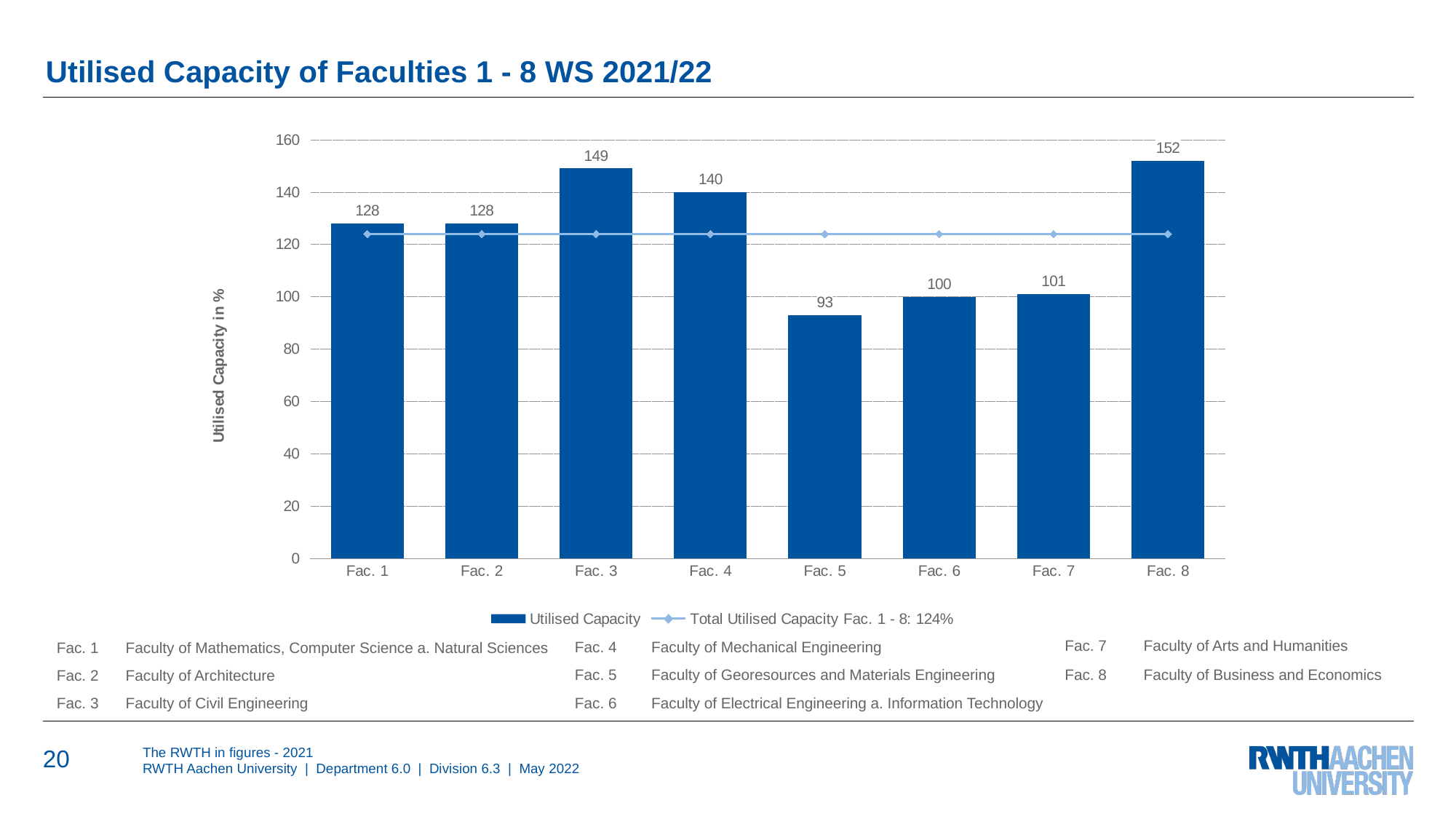
How many faculties are shown on the x axis? 8 Which has a higher utilised capacity, Fac. 4 or Fac. 7? Fac. 4 What kind of chart is used to show the utilised capacity of the faculties? bar chart Which faculty has the lowest utilised capacity? Fac. 5 What is the difference between the utilised capacity of Fac. 8 and Fac. 5? 59 What is the utilised capacity for Fac. 3? 149 What is the label of the y axis? Utilised Capacity in % What is the utilised capacity for Fac. 5? 93 Is the utilised capacity for Fac. 6 greater or less than 120? less What is the total utilised capacity for Fac. 1 - 8 according to the legend? 124% How many series does the legend list? 2 Which faculty has the highest utilised capacity? Fac. 8